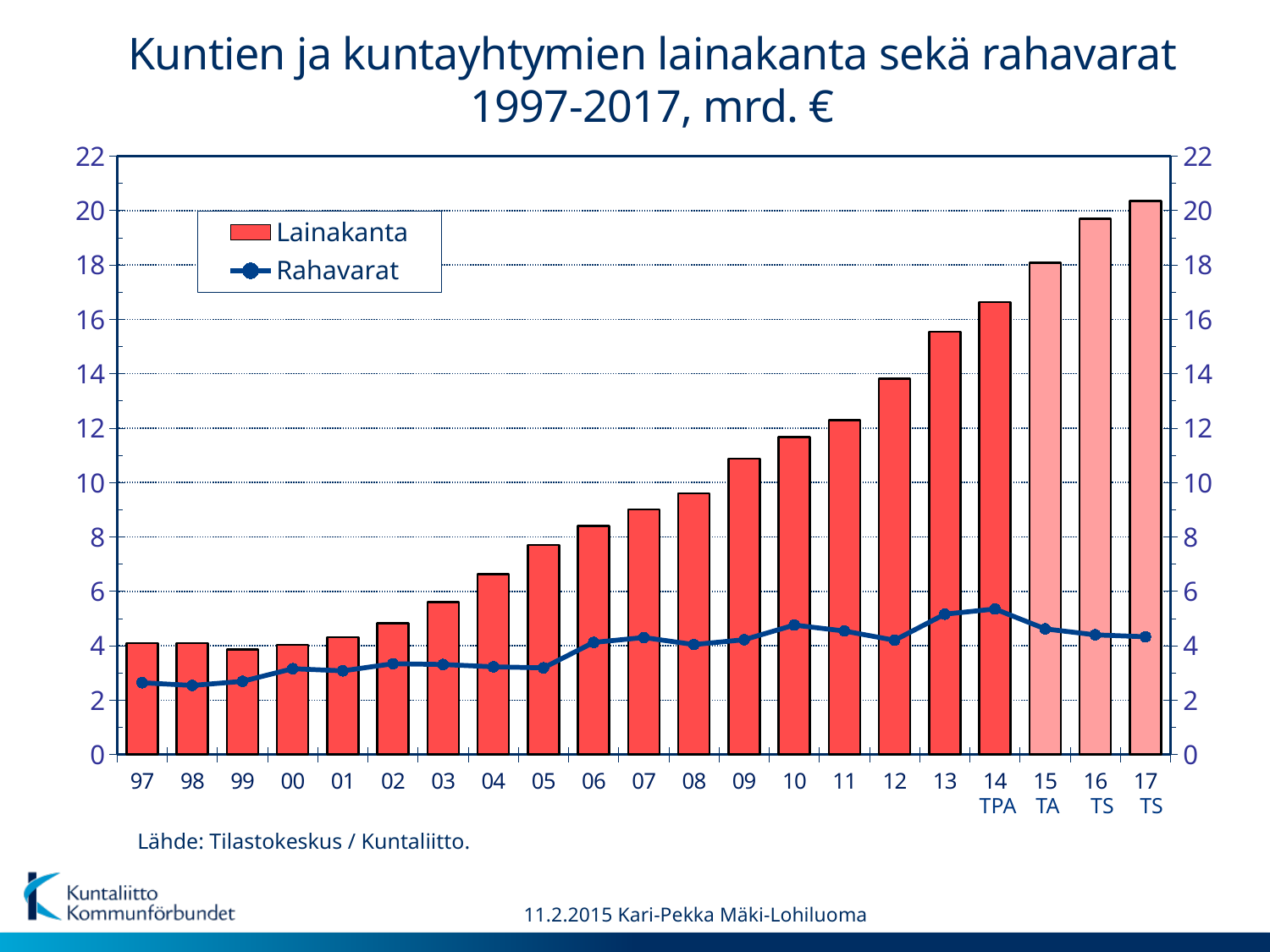
Is the Rahavarat value for 00 greater or less than 4? less Which series is drawn as a line with markers? Rahavarat Is the Lainakanta value for 16 greater or less than 20? less Which is larger, the Lainakanta value for 12 or for 08? 12 How many years are shown on the x axis? 21 Is the Rahavarat value for 14 greater or less than 4? greater Does the Lainakanta series generally rise or fall from 97 to 17? rise What kind of chart is shown on the slide? A combined bar and line chart How many series does the legend list? 2 Which year has the highest Lainakanta bar? 17